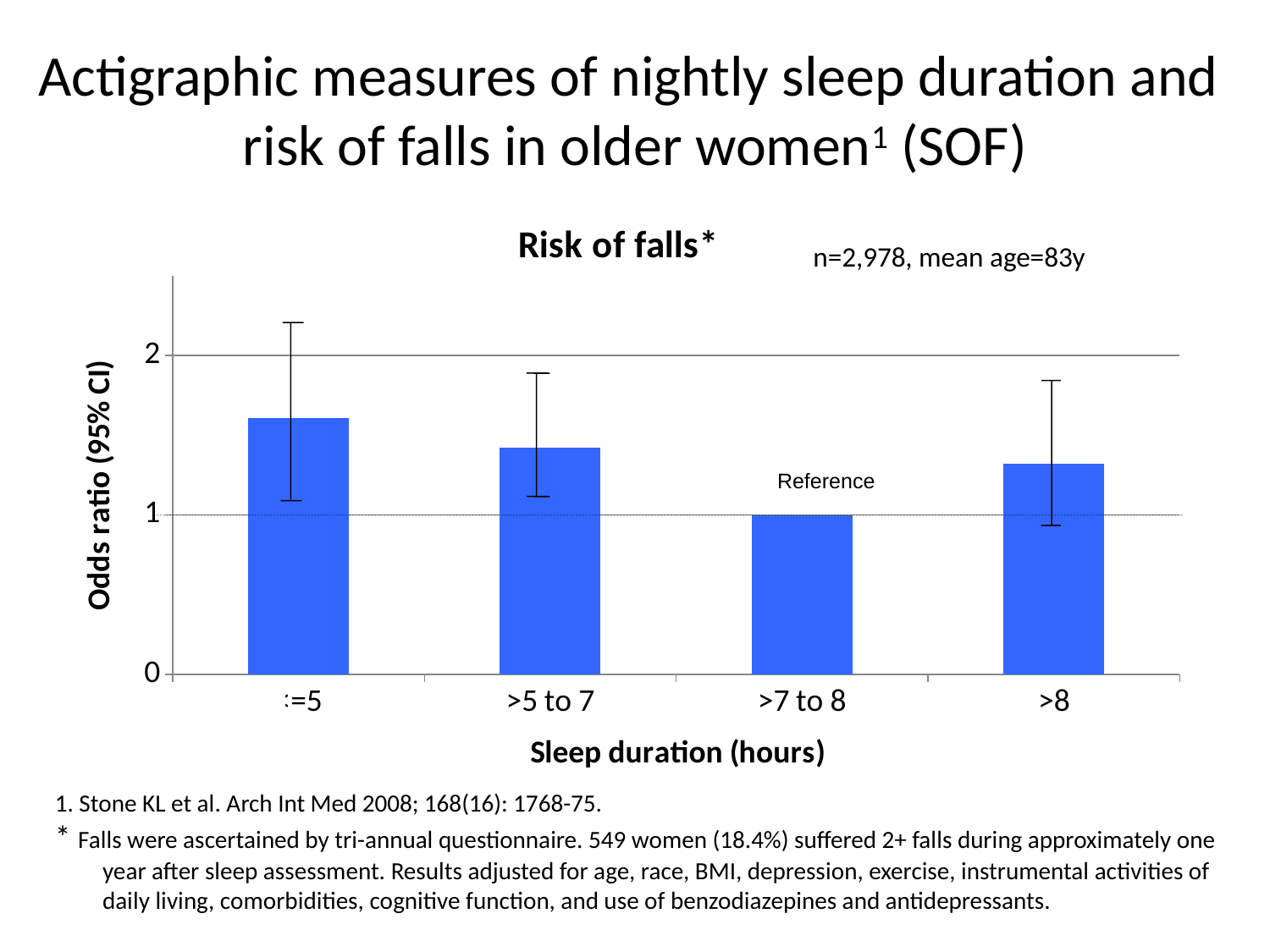
How many sleep duration categories are plotted in the chart? 4 Which has the larger odds ratio, the >5 to 7 hours category or the >7 to 8 hours category? >5 to 7 Which has the larger odds ratio, the leftmost category or the >8 hours category? the leftmost category Which sleep duration category has the lowest odds ratio? >7 to 8 What is the odds ratio for the >7 to 8 hours category? 1 What is the title of the vertical axis of the chart? Odds ratio (95% CI) Is the odds ratio for the leftmost bar greater or less than 2? less Which sleep duration category has the highest odds ratio? the leftmost category (≤5 hours) Is the odds ratio for the >5 to 7 hours category greater or less than 1? greater What kind of chart is shown on the slide? bar chart Is the odds ratio for the >8 hours category greater or less than 1? greater Which sleep duration category is labelled as the reference group? >7 to 8